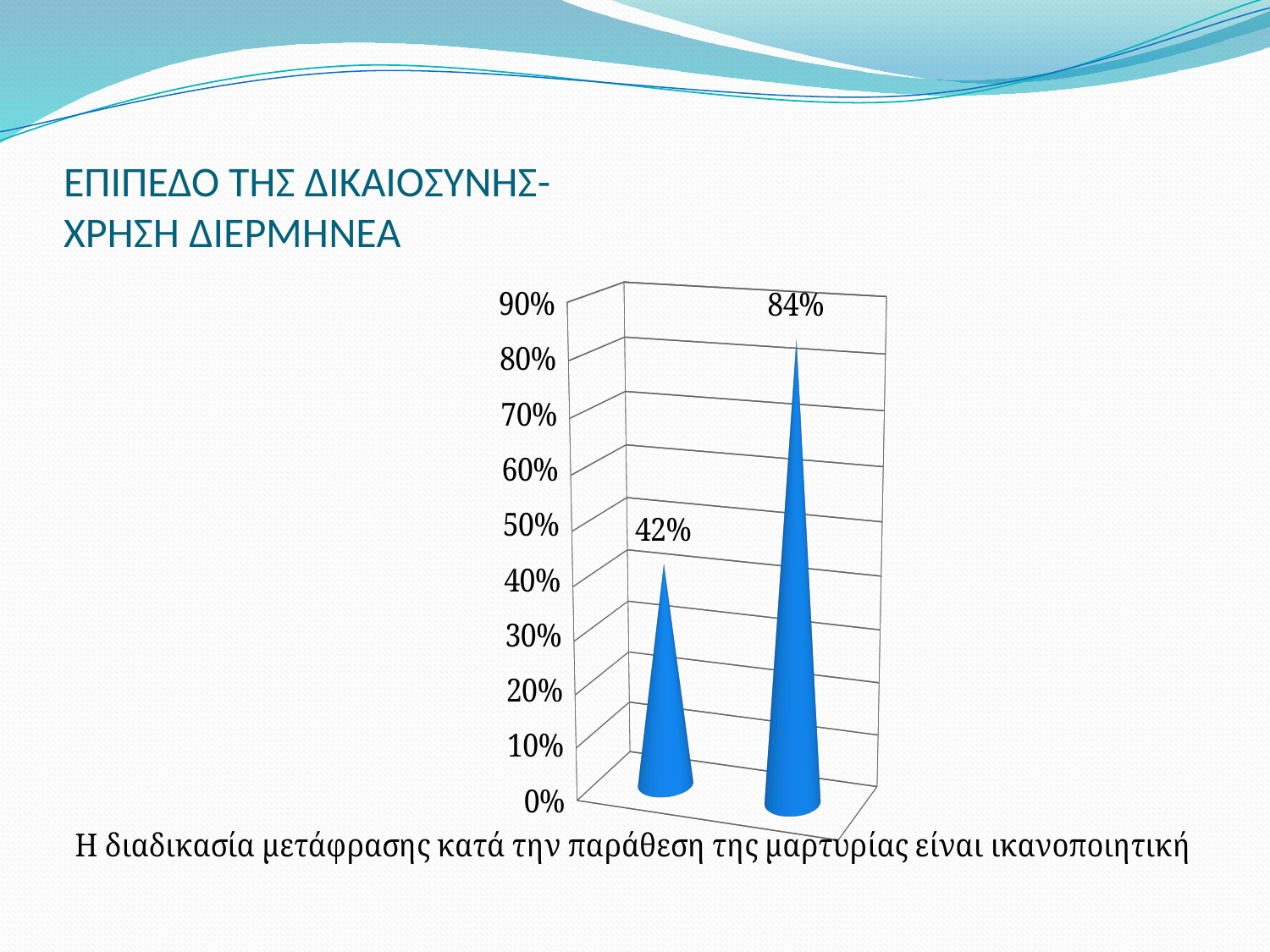
Which bar has the lowest value, the left or the right one? the left bar What kind of chart is shown on the slide? bar chart Is the value of the left bar larger or smaller than the value of the right bar? smaller What is the highest value shown on the vertical axis of the chart? 90% Is the value for the left bar greater or less than 50%? less How many bars are plotted in the chart? 2 Which bar has the highest value, the left or the right one? the right bar Do the values rise or fall from the left bar to the right bar? rise What value is shown for the left bar in the chart? 42% What value is shown for the right bar in the chart? 84% Is the value for the right bar greater or less than 80%? greater What is the difference between the right bar's value and the left bar's value? 42 percentage points